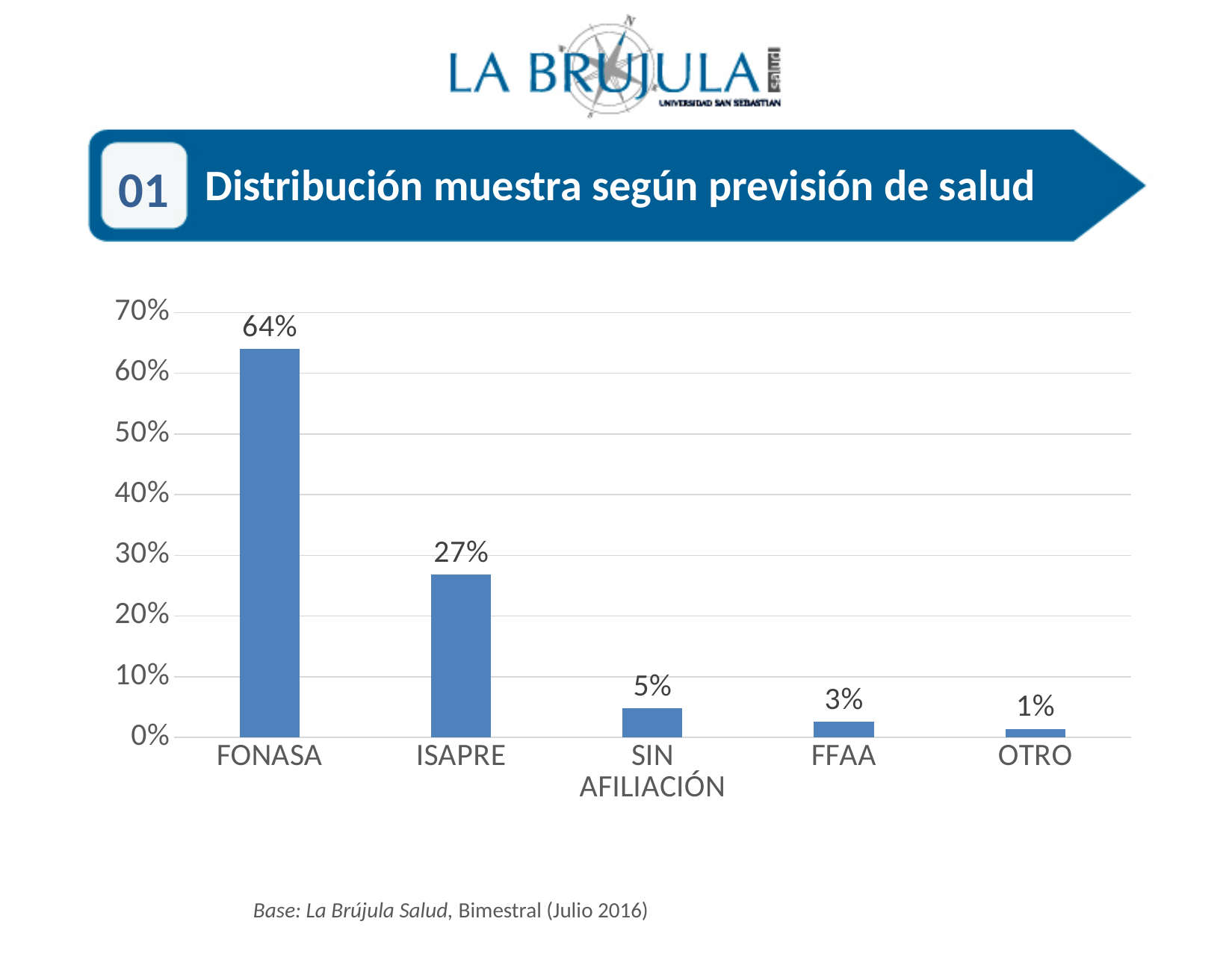
Which is larger, the value for SIN AFILIACIÓN or the value for FFAA? SIN AFILIACIÓN What is the value for FFAA? 3% What is the value for ISAPRE? 27% What is the value for SIN AFILIACIÓN? 5% What is the value for FONASA? 64% Is the value for ISAPRE greater or less than 30%? less What kind of chart is shown on the slide? bar chart What is the difference between the values for FONASA and ISAPRE? 37% How many categories are shown on the x axis? 5 What is the title of the chart? Distribución muestra según previsión de salud Which category has the highest value? FONASA Which category has the lowest value? OTRO